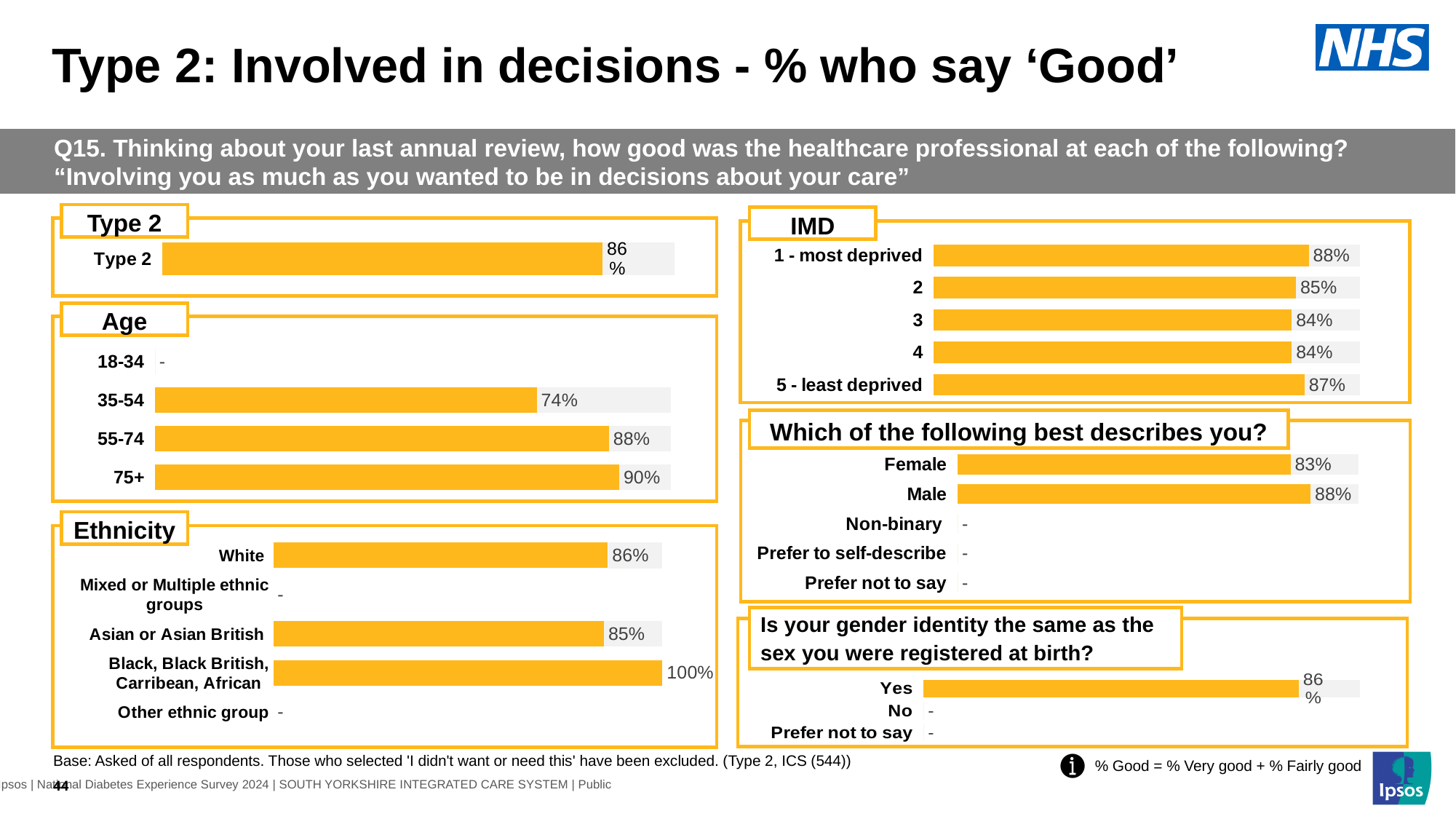
In the Ethnicity chart, which is larger, the value for White or for Asian or Asian British? White In the 'Is your gender identity the same as the sex you were registered at birth?' chart, what is the value for Yes? 86% In the Age chart, which age group with a plotted value has the highest percentage? 75+ In the Type 2 chart, what percentage of Type 2 respondents say 'Good'? 86% In the IMD chart, what is the value for 1 - most deprived? 88% In the 'Which of the following best describes you?' chart, what is the difference between the Male and Female values? 5 percentage points In the Age chart, what is the difference between the 75+ and 35-54 values? 16 percentage points In the Ethnicity chart, what is the value for Black, Black British, Carribean, African? 100% What type of chart is used in the Age section? Bar chart In the IMD chart, which IMD group has the lowest percentage? 3 and 4 (both 84%) In the IMD chart, how many categories are listed? 5 In the Age chart, what is the value for the 35-54 age group? 74%